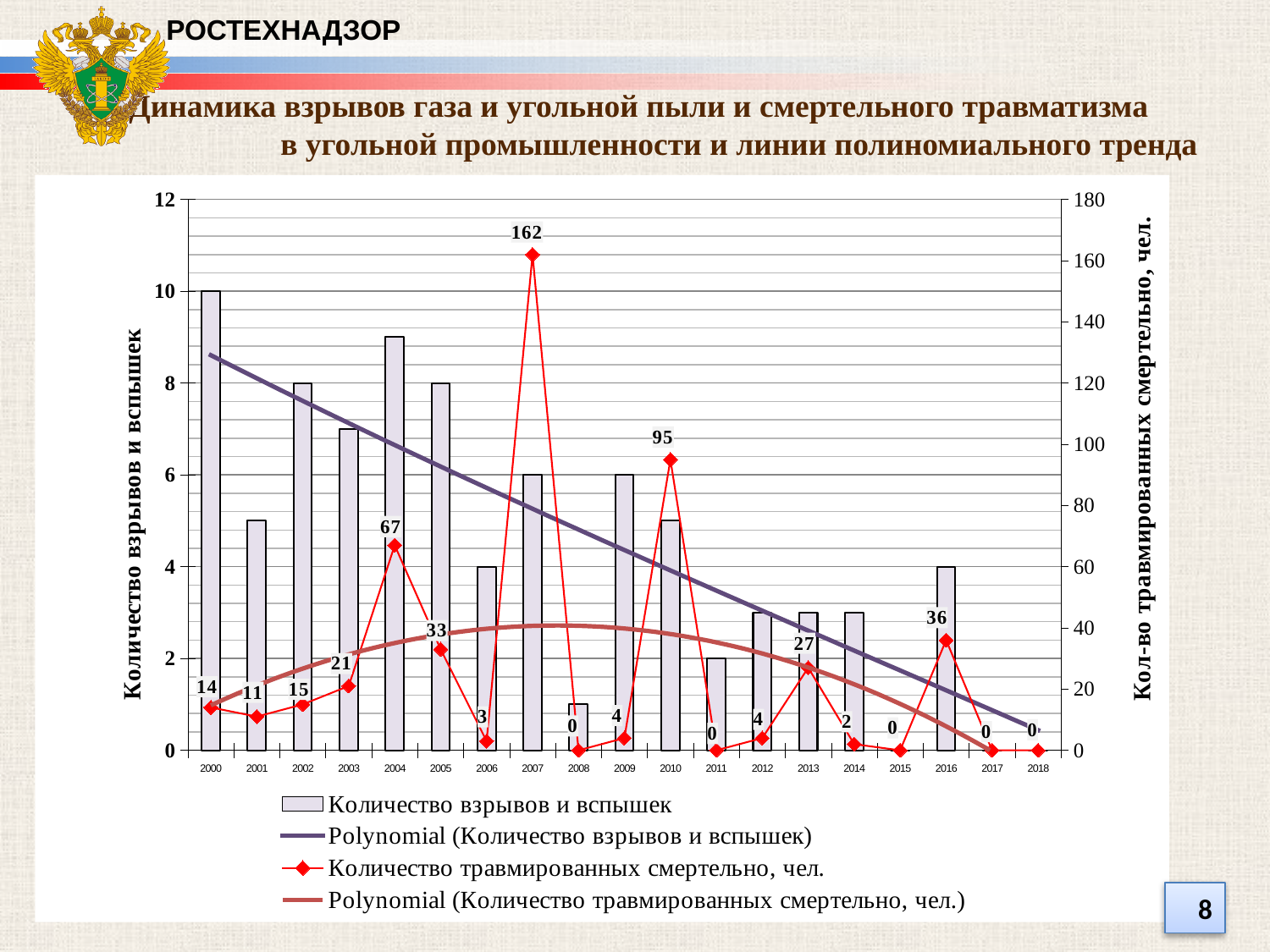
Does the polynomial trend line for explosions and flashes rise or fall from 2000 to 2018? It falls How many people were fatally injured (Количество травмированных смертельно) in 2007? 162 What is the difference between the number of fatally injured people in 2004 and in 2005? 34 How many years are shown on the x axis of the chart? 19 What kind of chart is shown on the slide? A combined bar and line chart How many series does the legend list? 4 Which year had more fatally injured people, 2013 or 2016? 2016 What is the value of the fatal injuries series for 2010? 95 How many explosions and flashes (Количество взрывов и вспышек) were recorded in 2000? 10 What is the value of the fatal injuries series for 2016? 36 Is the number of explosions and flashes in 2004 greater or less than 8? greater In which year was the number of fatally injured people the highest? 2007